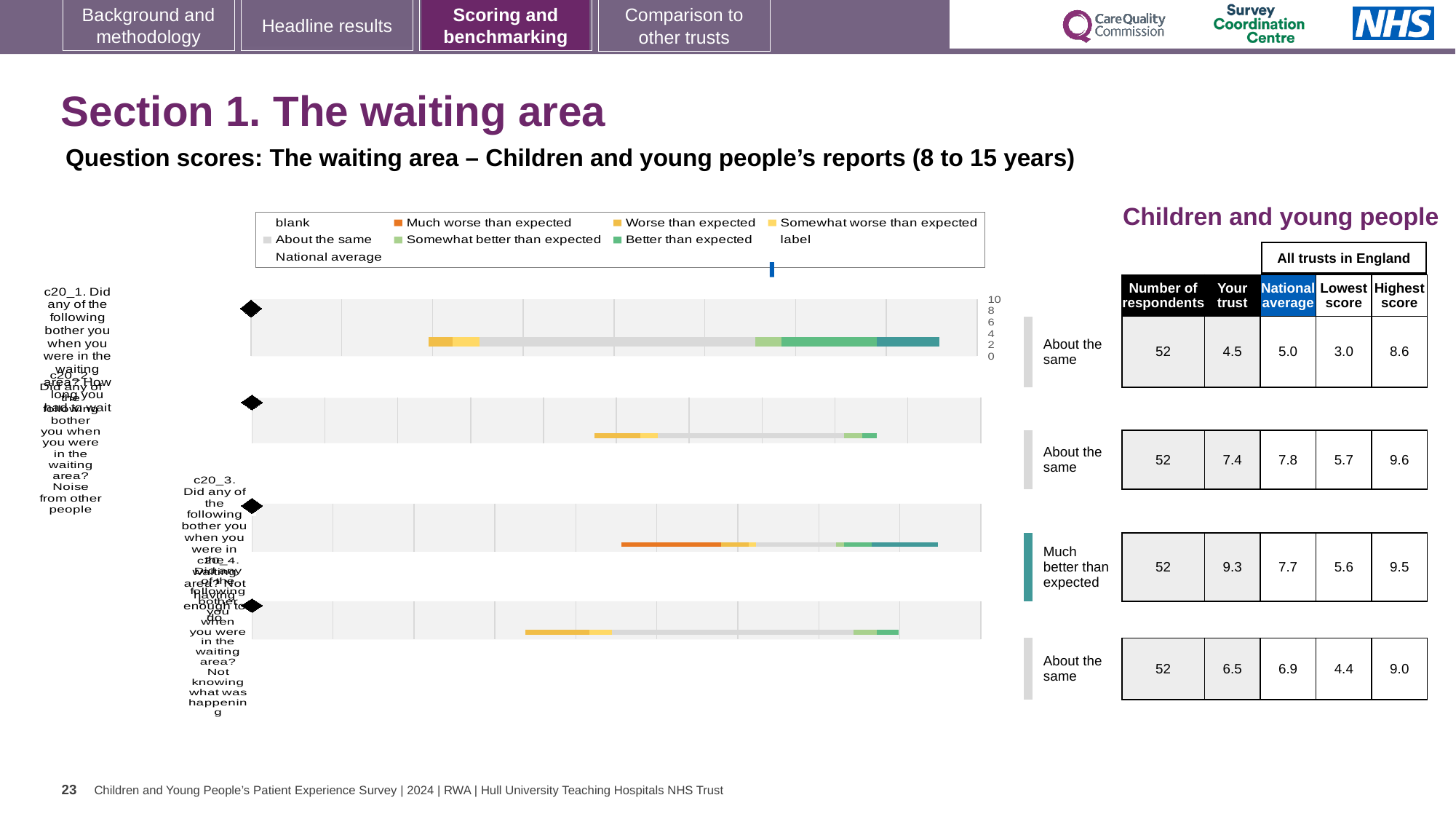
What kind of chart is shown on the slide? bar chart For the third question (c20_3), what is the difference between the 'Your trust' score and the national average? 1.6 In the table beside the chart, what is the national average for the first question (c20_1)? 5.0 What colour does the legend use for 'Much worse than expected'? orange In the table beside the chart, how many respondents are listed for each question? 52 Which question row has the highest 'Your trust' score in the table beside the chart? c20_3 (9.3) How many question bars are plotted in the chart? 4 Which question row has the lowest 'Your trust' score in the table beside the chart? c20_1 (4.5) What is the highest value shown on the chart's axis scale? 10 How many entries does the chart legend list? 9 In the table beside the chart, what is the 'Your trust' score for the third question (c20_3)? 9.3 For the third question (c20_3), is the 'Your trust' score larger or smaller than the national average? larger